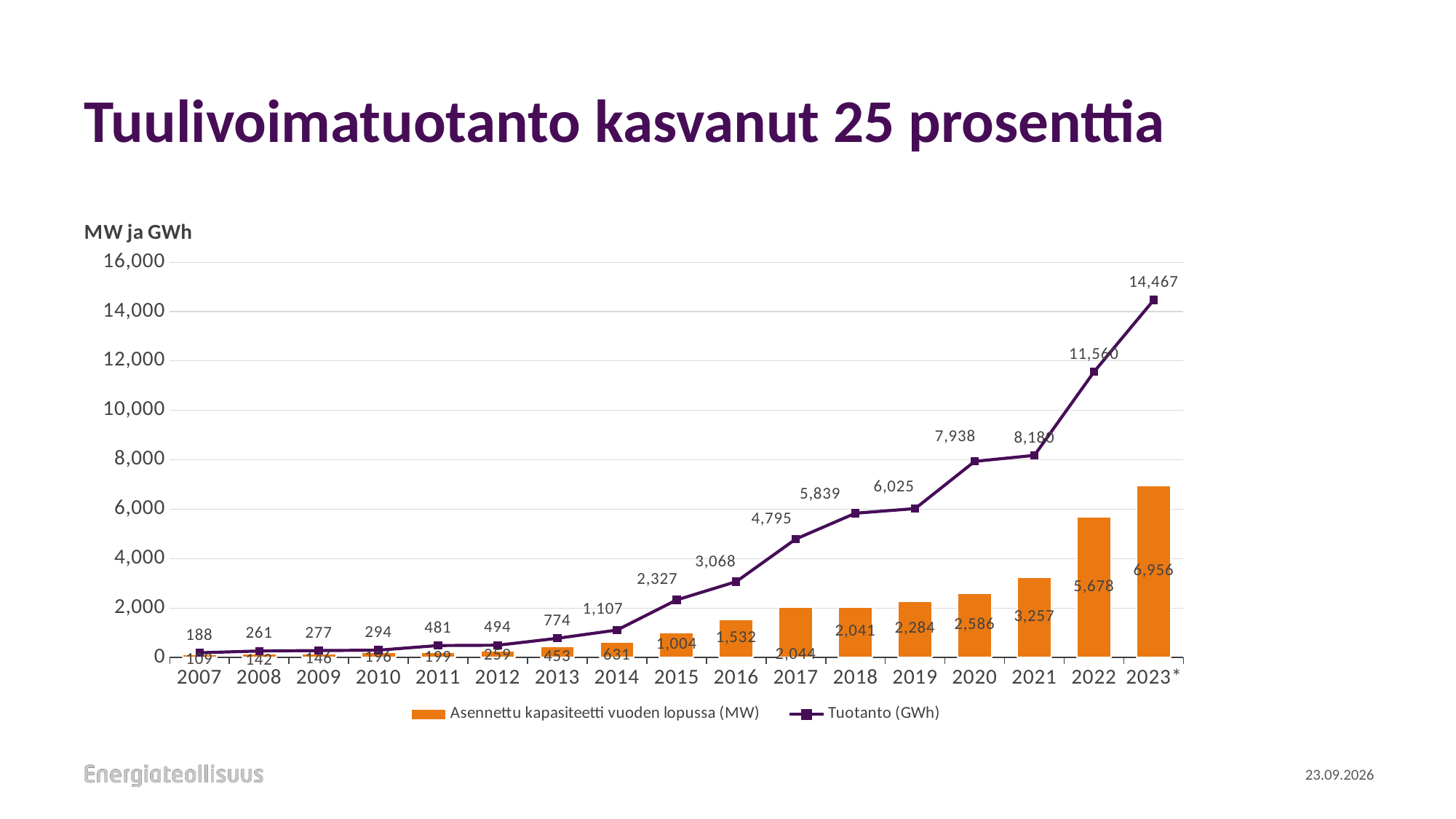
What is the difference between the Tuotanto (GWh) values for 2023* and 2022? 2,907 Does the Tuotanto (GWh) series rise or fall from 2007 to 2023*? rise What is the difference between the Asennettu kapasiteetti vuoden lopussa (MW) values for 2022 and 2021? 2,421 What is the Asennettu kapasiteetti vuoden lopussa (MW) value for 2022? 5,678 How many series does the legend list? 2 What is the Tuotanto (GWh) value for 2015? 2,327 Which is larger, the Tuotanto (GWh) value for 2020 or for 2021? 2021 Which year has the lowest Asennettu kapasiteetti vuoden lopussa (MW) value? 2007 Which year has the highest Tuotanto (GWh) value? 2023* What is the Tuotanto (GWh) value for 2023*? 14,467 How many years are shown on the x axis? 17 Is the Tuotanto (GWh) value for 2022 greater or less than 10,000? greater